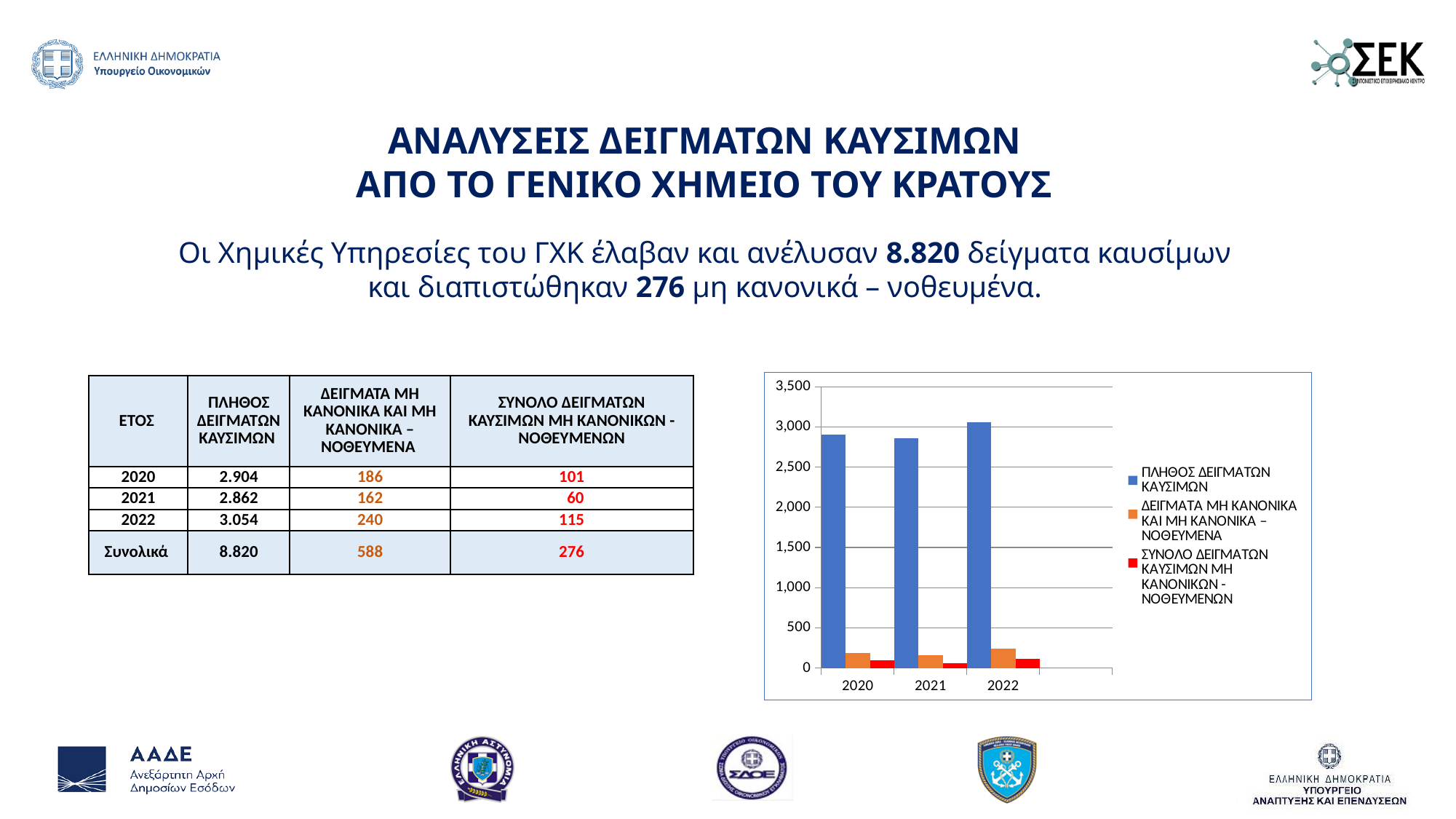
According to the table, what is the value of ΔΕΙΓΜΑΤΑ ΜΗ ΚΑΝΟΝΙΚΑ ΚΑΙ ΜΗ ΚΑΝΟΝΙΚΑ – ΝΟΘΕΥΜΕΝΑ for 2022? 240 How many series does the chart's legend list? 3 In which year is the bar for ΣΥΝΟΛΟ ΔΕΙΓΜΑΤΩΝ ΚΑΥΣΙΜΩΝ ΜΗ ΚΑΝΟΝΙΚΩΝ - ΝΟΘΕΥΜΕΝΩΝ the lowest? 2021 How many years are shown on the x axis of the chart? 3 What colour is used for the ΠΛΗΘΟΣ ΔΕΙΓΜΑΤΩΝ ΚΑΥΣΙΜΩΝ series in the chart? blue Is the value for ΠΛΗΘΟΣ ΔΕΙΓΜΑΤΩΝ ΚΑΥΣΙΜΩΝ in 2020 greater or less than 3,000? less Is the value for ΠΛΗΘΟΣ ΔΕΙΓΜΑΤΩΝ ΚΑΥΣΙΜΩΝ in 2022 greater or less than 3,000? greater In which year is the bar for ΠΛΗΘΟΣ ΔΕΙΓΜΑΤΩΝ ΚΑΥΣΙΜΩΝ the highest? 2022 Is the value for ΔΕΙΓΜΑΤΑ ΜΗ ΚΑΝΟΝΙΚΑ ΚΑΙ ΜΗ ΚΑΝΟΝΙΚΑ – ΝΟΘΕΥΜΕΝΑ in 2022 greater or less than 500? less What kind of chart is shown on the right of the slide? bar chart Which year has the larger bar for ΠΛΗΘΟΣ ΔΕΙΓΜΑΤΩΝ ΚΑΥΣΙΜΩΝ, 2020 or 2022? 2022 Do the bars for ΠΛΗΘΟΣ ΔΕΙΓΜΑΤΩΝ ΚΑΥΣΙΜΩΝ rise or fall from 2021 to 2022? rise